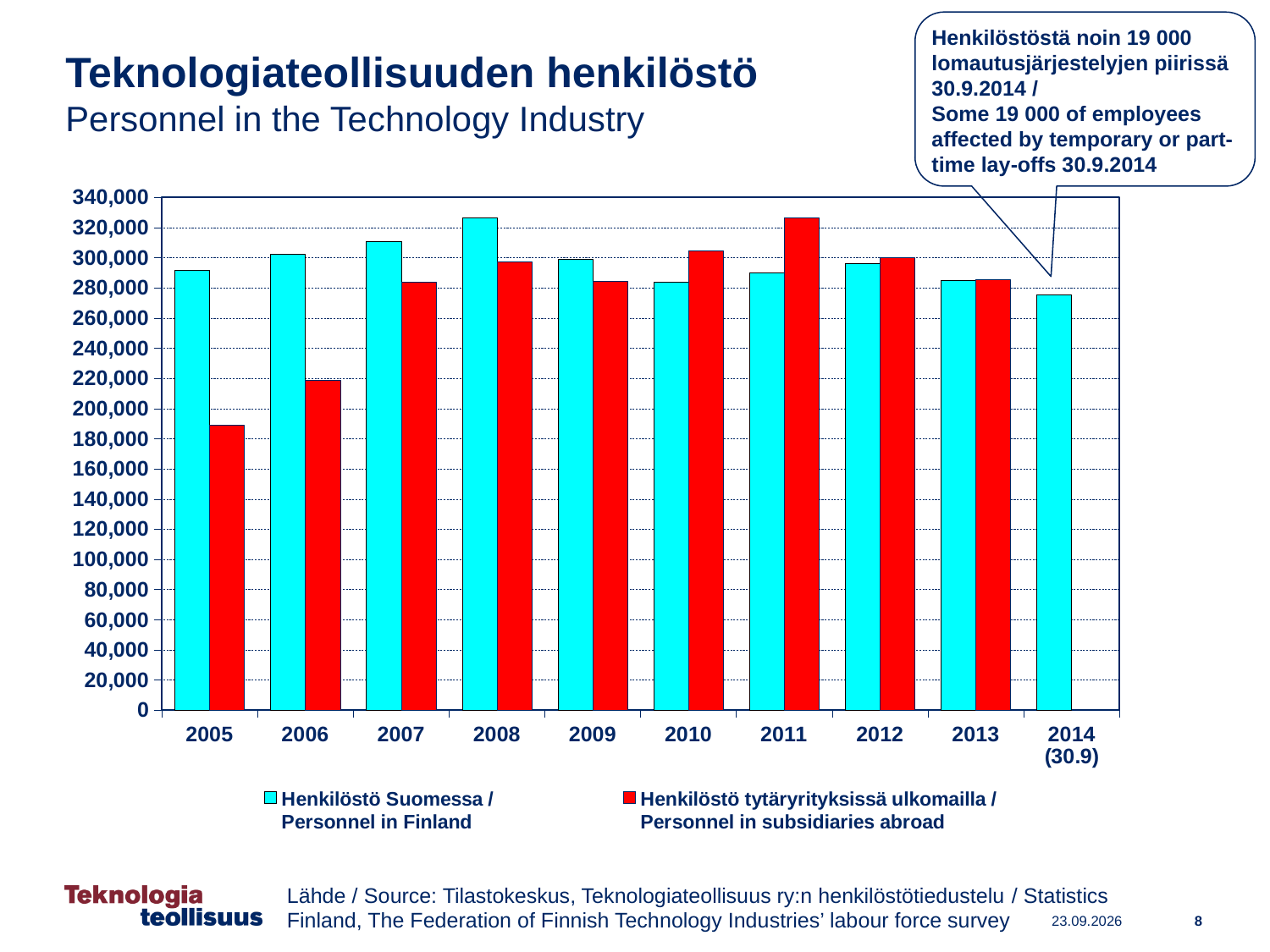
Does Personnel in subsidiaries abroad rise or fall from 2005 to 2008? Rise In which year is Personnel in subsidiaries abroad lowest? 2005 In which year is Personnel in Finland highest? 2008 How many years are shown on the x axis? 10 In 2005, which is larger: Personnel in Finland or Personnel in subsidiaries abroad? Personnel in Finland Is the value for Personnel in subsidiaries abroad in 2005 greater or less than 200,000? less How many series does the legend list? 2 What kind of chart is shown on the slide? Bar chart Which year on the x axis has only one bar? 2014 (30.9) In which year is Personnel in subsidiaries abroad highest? 2011 Is the value for Personnel in Finland in 2008 greater or less than 320,000? greater In 2011, which is larger: Personnel in Finland or Personnel in subsidiaries abroad? Personnel in subsidiaries abroad